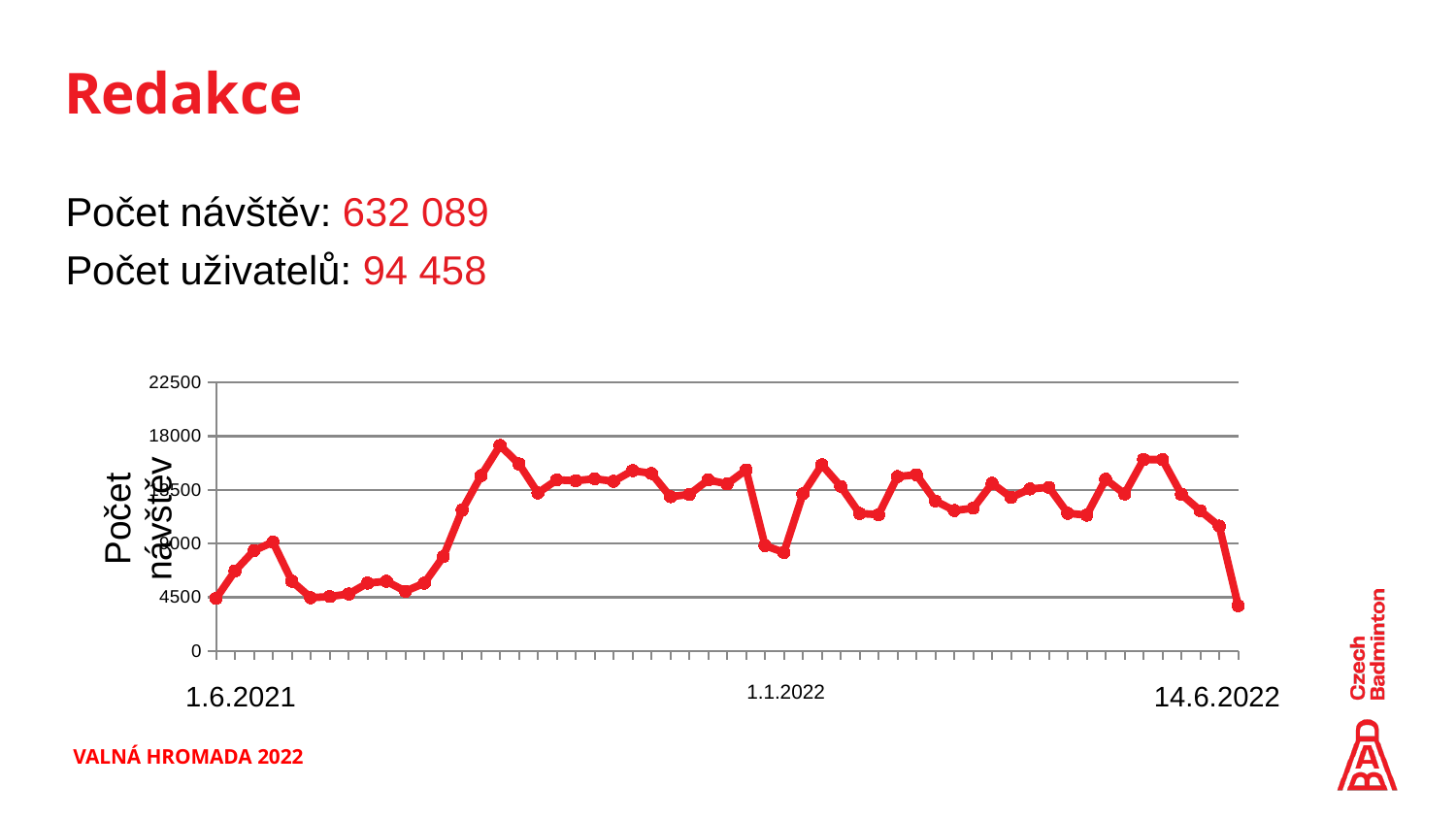
Is the value around 1.1.2022 greater or less than 13500? less What kind of chart is shown on the slide? line chart What is the first date label on the horizontal axis of the chart? 1.6.2021 How many lines (series) are plotted in the chart? 1 Does the line rise or fall over the last few points before 14.6.2022? fall What is the last date label on the horizontal axis of the chart? 14.6.2022 What is the title of the vertical axis of the chart? Počet návštěv Is the value at the last point of the line (14.6.2022) greater or less than 9000? less Is the highest point of the line in the chart greater or less than 13500? greater Does the line rise or fall between the first point (1.6.2021) and the peak in the middle of 2021? rise What is the highest value shown on the vertical axis of the chart? 22500